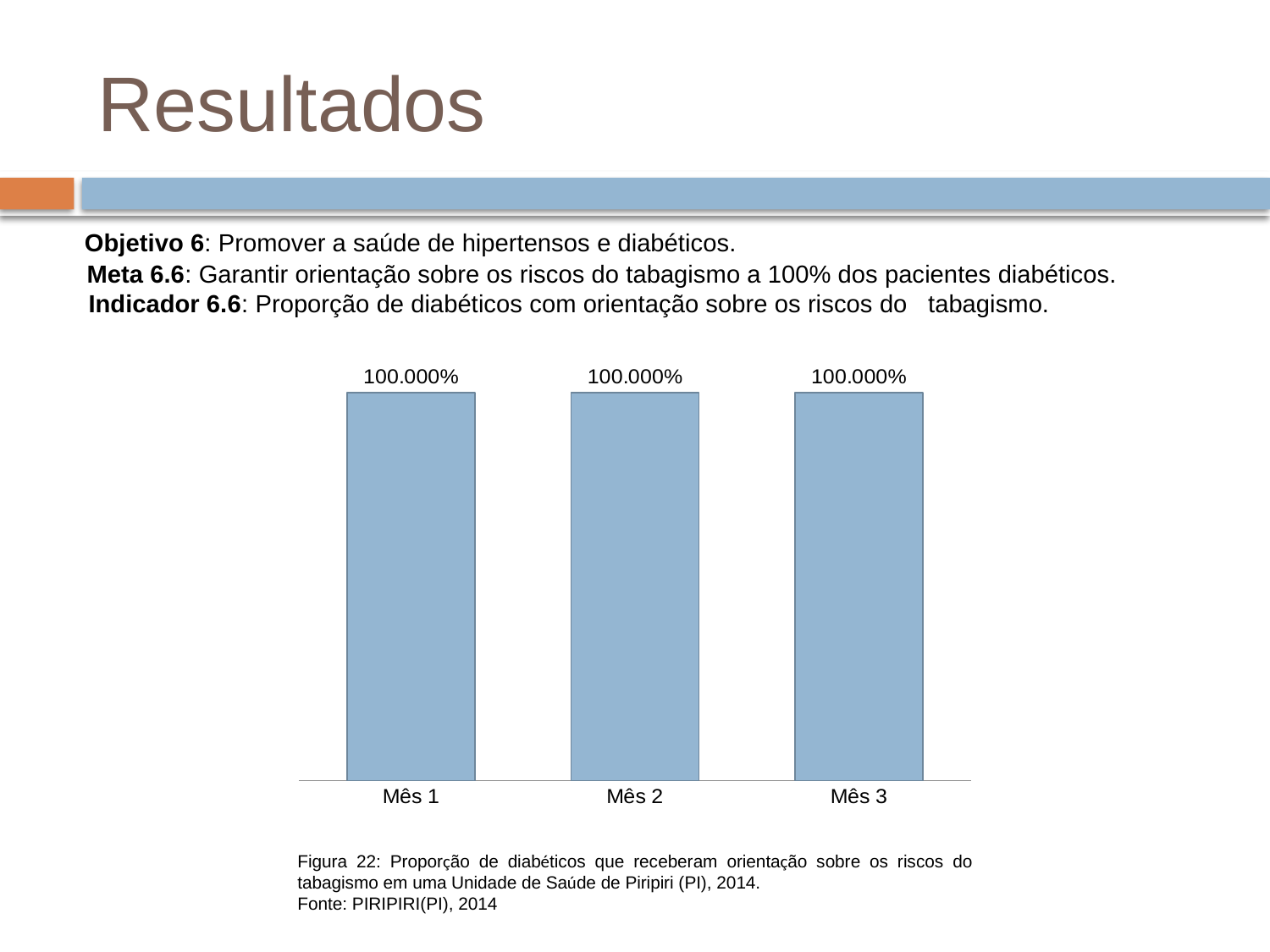
What is the difference between the values for Mês 1 and Mês 3? 0.000% Do the values rise, fall, or stay the same from Mês 1 to Mês 3? stay the same What is the value for Mês 1? 100.000% What is the value for Mês 2? 100.000% What is the figure number given in the caption below the chart? Figura 22 What kind of chart is shown on the slide? bar chart What is the value for Mês 3? 100.000% How many categories are shown on the x axis of the chart? 3 What is the label of the first category on the x axis? Mês 1